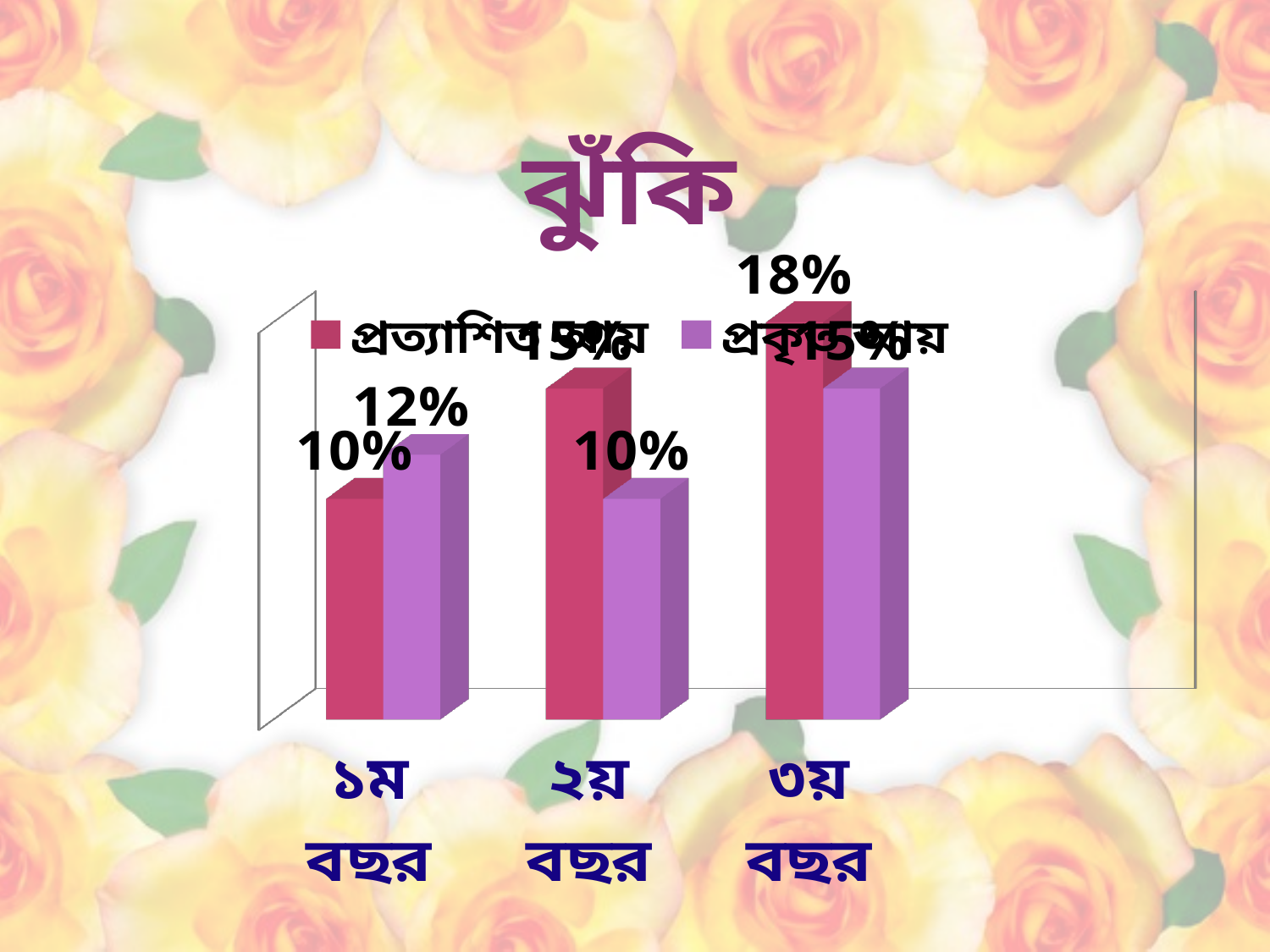
Which category has the lowest value for প্রকৃত আয় (actual income)? ২য় বছর What kind of chart is shown on the slide? bar chart Which category has the highest value for প্রত্যাশিত আয় (expected income)? ৩য় বছর What is the value of প্রত্যাশিত আয় (expected income) for ৩য় বছর (3rd year)? 18% How many categories are shown on the x axis? 3 Does the value of প্রত্যাশিত আয় (expected income) rise or fall from ১ম বছর to ৩য় বছর? rise What is the value of প্রকৃত আয় (actual income) for ১ম বছর (1st year)? 12% For ১ম বছর (1st year), which is larger: প্রত্যাশিত আয় or প্রকৃত আয়? প্রকৃত আয় What is the value of প্রত্যাশিত আয় (expected income) for ১ম বছর (1st year)? 10% What is the value of প্রকৃত আয় (actual income) for ২য় বছর (2nd year)? 10% How many series does the legend list? 2 What is the difference between প্রত্যাশিত আয় and প্রকৃত আয় for ২য় বছর (2nd year)? 5%